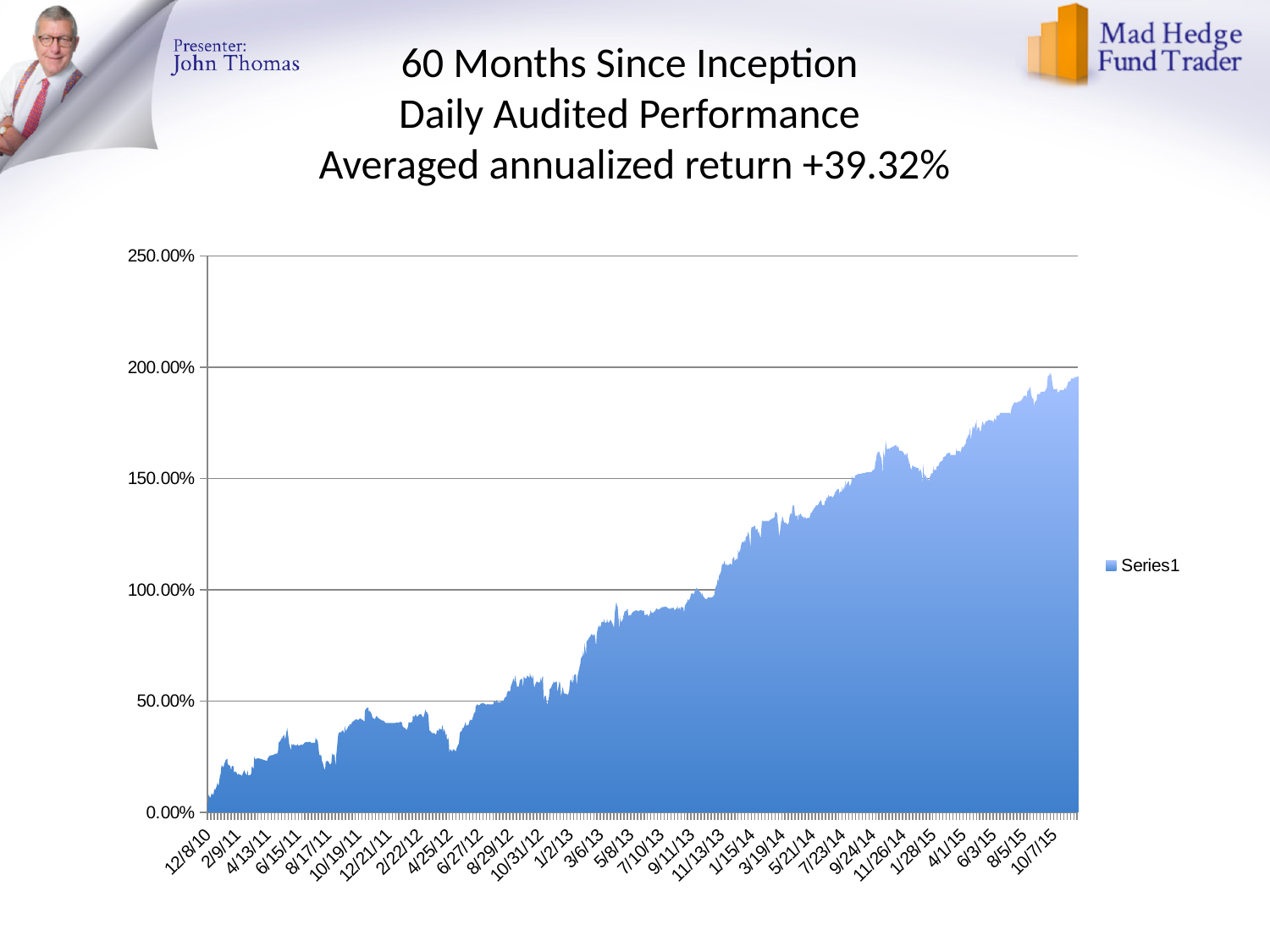
Is the value for 6/15/11 greater or less than 50.00%? less How many series does the legend list? 1 What is the highest value shown on the y axis? 250.00% What kind of chart is shown on the slide? area chart Which is larger, the value for 4/25/12 or the value for 9/24/14? 9/24/14 What is the name of the series shown in the legend? Series1 Which is larger, the value for 10/7/15 or the value for 2/9/11? 10/7/15 Is the value for 8/5/15 greater or less than 150.00%? greater Is the value for 12/8/10 greater or less than 50.00%? less Do the values generally rise or fall from 12/8/10 to 10/7/15? rise